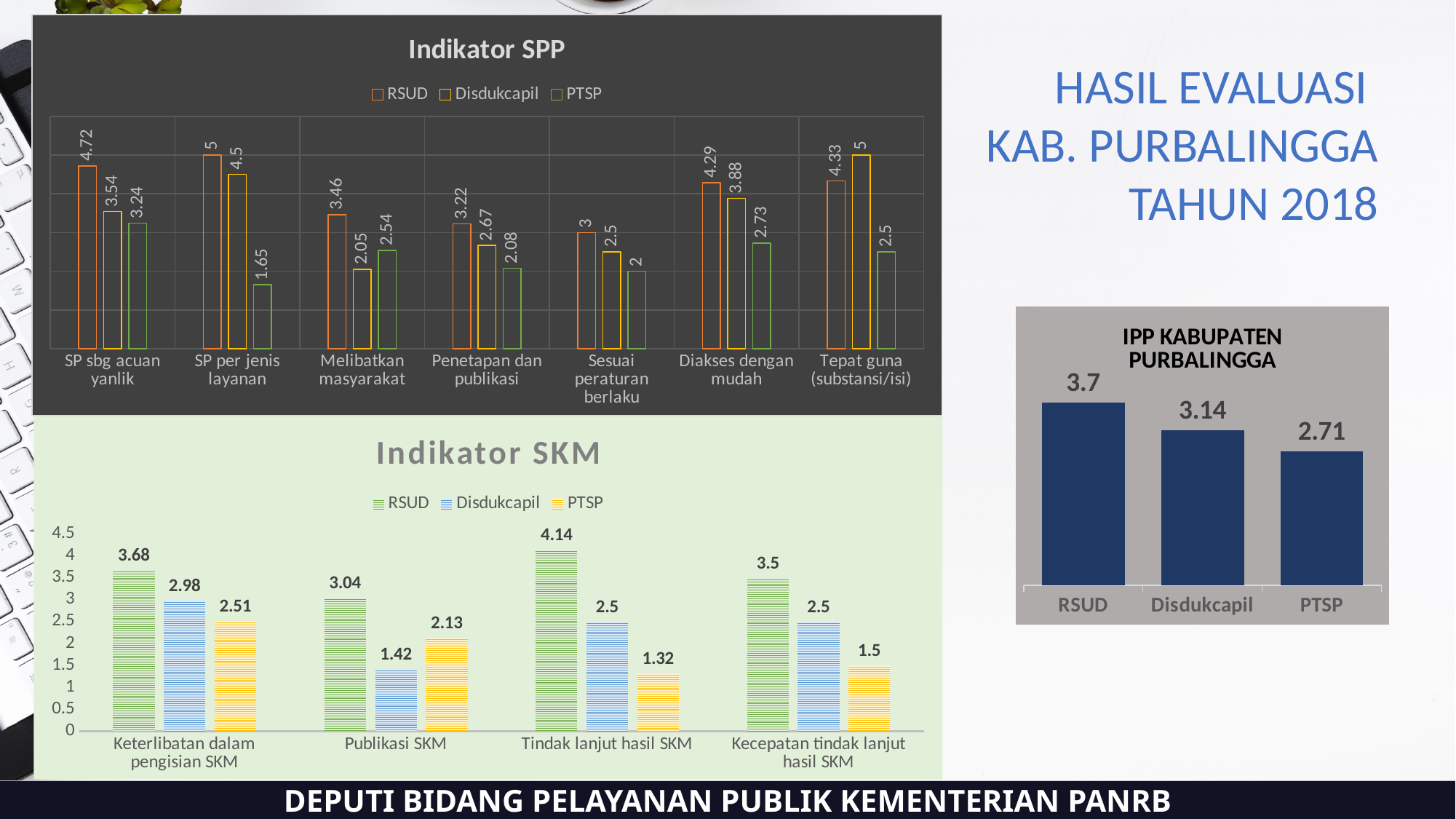
In the "Indikator SKM" chart, which category has the highest RSUD value? Tindak lanjut hasil SKM In the "Indikator SKM" chart, which is larger for "Keterlibatan dalam pengisian SKM": the Disdukcapil value or the PTSP value? Disdukcapil In the "Indikator SPP" chart, which category has the lowest Disdukcapil value? Melibatkan masyarakat In the "Indikator SPP" chart, what is the difference between the RSUD and PTSP values for "Diakses dengan mudah"? 1.56 In the "IPP KABUPATEN PURBALINGGA" chart, what is the value for Disdukcapil? 3.14 What kind of chart is the "IPP KABUPATEN PURBALINGGA" chart? Bar chart In the "Indikator SPP" chart, what is the RSUD value for "SP sbg acuan yanlik"? 4.72 In the "Indikator SKM" chart, what is the Disdukcapil value for "Publikasi SKM"? 1.42 In the "IPP KABUPATEN PURBALINGGA" chart, what is the difference between the RSUD and PTSP values? 0.99 In the "Indikator SPP" chart, how many categories are shown on the x axis? 7 In the "Indikator SPP" chart, what is the PTSP value for "SP per jenis layanan"? 1.65 In the "Indikator SKM" chart, how many series does the legend list? 3